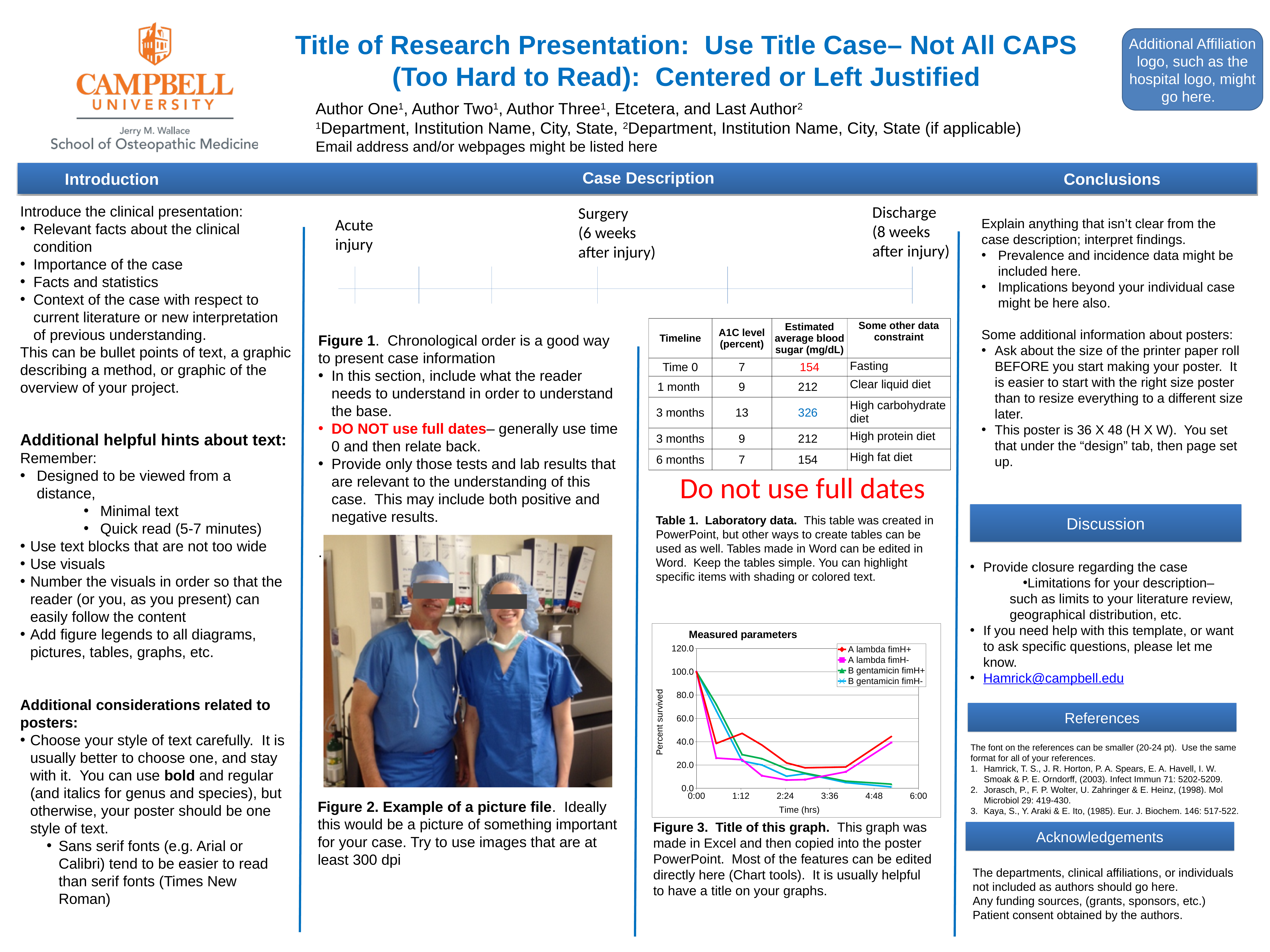
What is the label of the vertical axis in the "Measured parameters" chart? Percent survived In the "Measured parameters" chart, is the value for B gentamicin fimH+ at 4:48 greater or less than 20? less In the "Measured parameters" chart, at the last time point plotted, which is higher: A lambda fimH+ or B gentamicin fimH+? A lambda fimH+ In the "Measured parameters" chart, does the B gentamicin fimH- series generally rise or fall as time increases? fall In the "Measured parameters" chart, is the value for A lambda fimH+ at 1:12 greater or less than 40? greater In the "Measured parameters" chart, is the value for A lambda fimH- at 2:24 greater or less than 20? less In the "Measured parameters" chart, at 3:36, which is higher: A lambda fimH+ or B gentamicin fimH-? A lambda fimH+ In the "Measured parameters" chart, what is the value of A lambda fimH+ at time 0:00? 100.0 What is the title of the graph in Figure 3? Measured parameters What kind of chart is the "Measured parameters" chart? line chart How many series does the legend of the "Measured parameters" chart list? 4